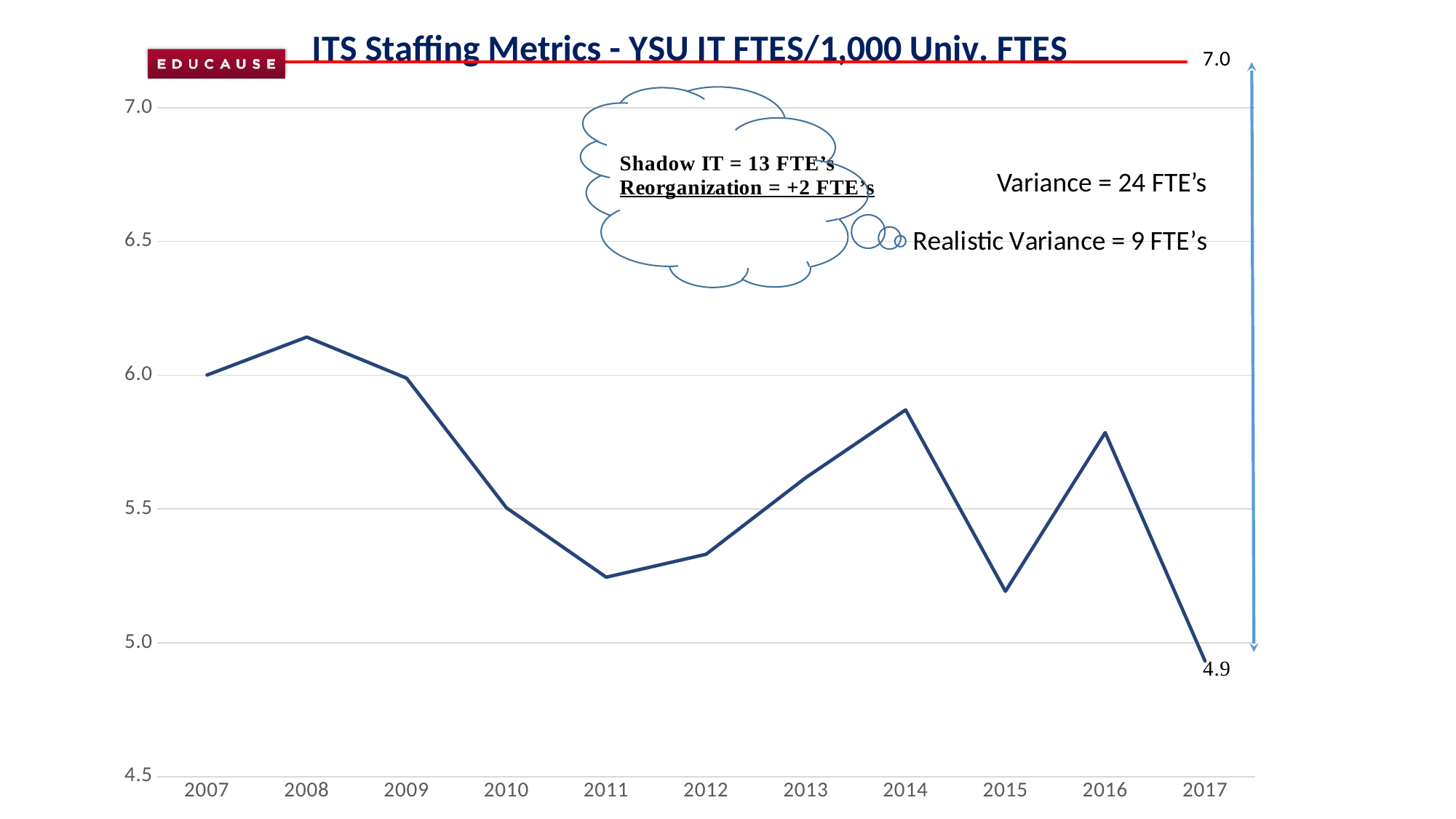
What is the value for 2017? 4.9 What value does the red horizontal reference line at the top of the chart mark? 7.0 Which year has the lowest value? 2017 Which year has the highest value? 2008 What is the title of the chart? ITS Staffing Metrics - YSU IT FTES/1,000 Univ. FTES Which is larger, the value for 2014 or the value for 2015? 2014 Is the value for 2014 greater or less than 5.5? greater What kind of chart is shown on the slide? line chart Is the value for 2008 greater or less than 6.0? greater Is the value for 2011 greater or less than 5.5? less How many years are plotted along the x axis? 11 Do the values rise or fall from 2014 to 2015? fall